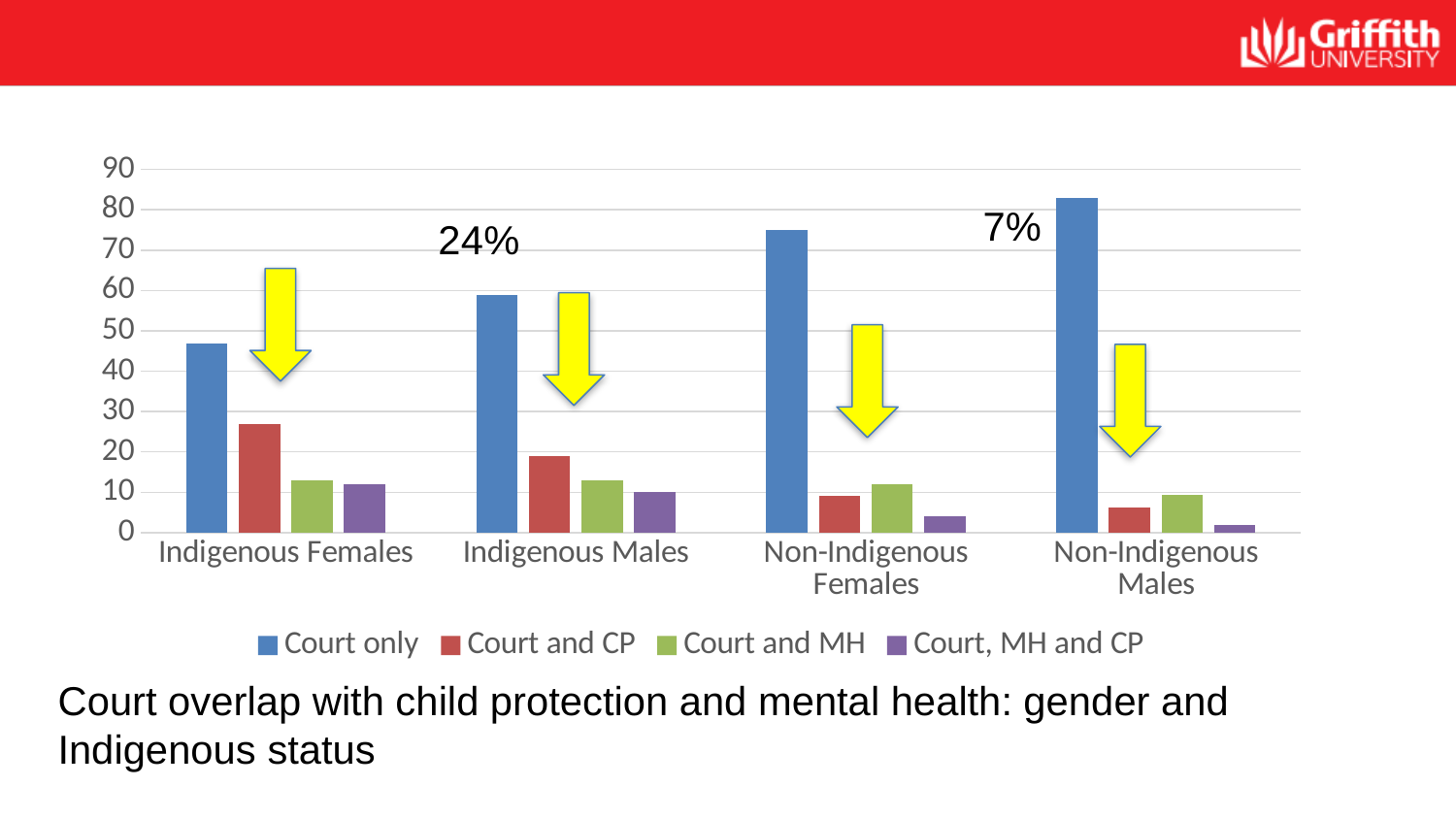
Which category has the lowest Court only value? Indigenous Females Do the Court only values rise or fall from Indigenous Females to Non-Indigenous Males along the x axis? rise Is the Court only value for Indigenous Females greater or less than 50? less What colour are the Court only bars? blue How many series does the legend list? 4 Is the Court and CP value for Indigenous Females greater or less than 20? greater Which is larger for Indigenous Males: Court only or Court and CP? Court only Which category has the highest Court and CP value? Indigenous Females How many categories are shown on the x axis? 4 What kind of chart is shown on the slide? bar chart Is the Court only value for Non-Indigenous Males greater or less than 80? greater Which category has the highest Court only value? Non-Indigenous Males